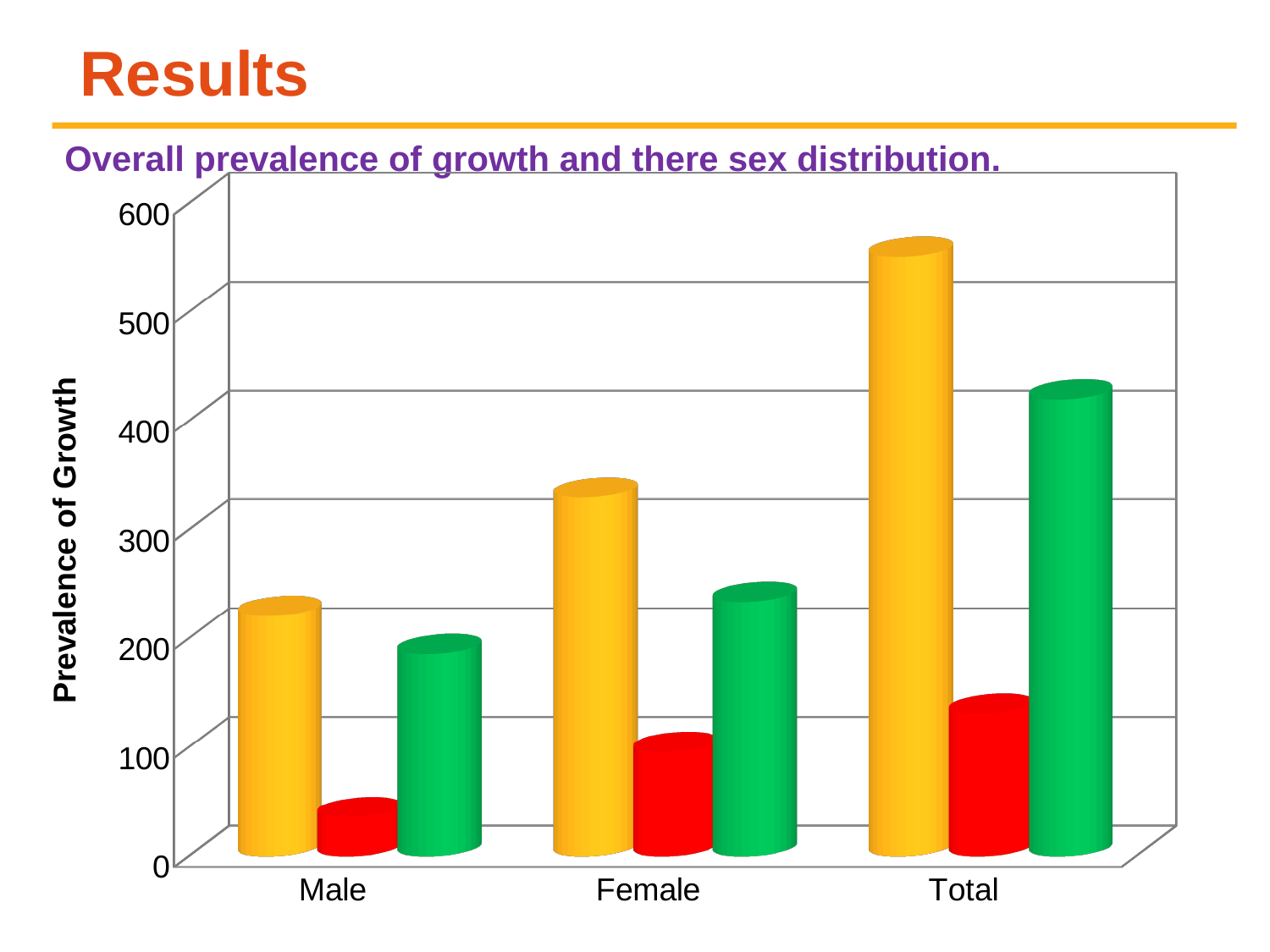
Which category has the tallest yellow bar? Total Is the value of the yellow bar for Total greater or less than 500? greater Which category has the shortest red bar? Male For Female, which is larger: the yellow bar or the green bar? the yellow bar What is the title of the chart? Overall prevalence of growth and there sex distribution. Is the value of the red bar for Male greater or less than 100? less What kind of chart is shown on the slide? bar chart How many categories are shown on the x axis of the chart? 3 Do the yellow bars rise or fall from Male to Total along the x axis? rise What is the title of the vertical axis of the chart? Prevalence of Growth Is the value of the yellow bar for Female greater or less than 300? greater How many bars are plotted for each category in the chart? 3